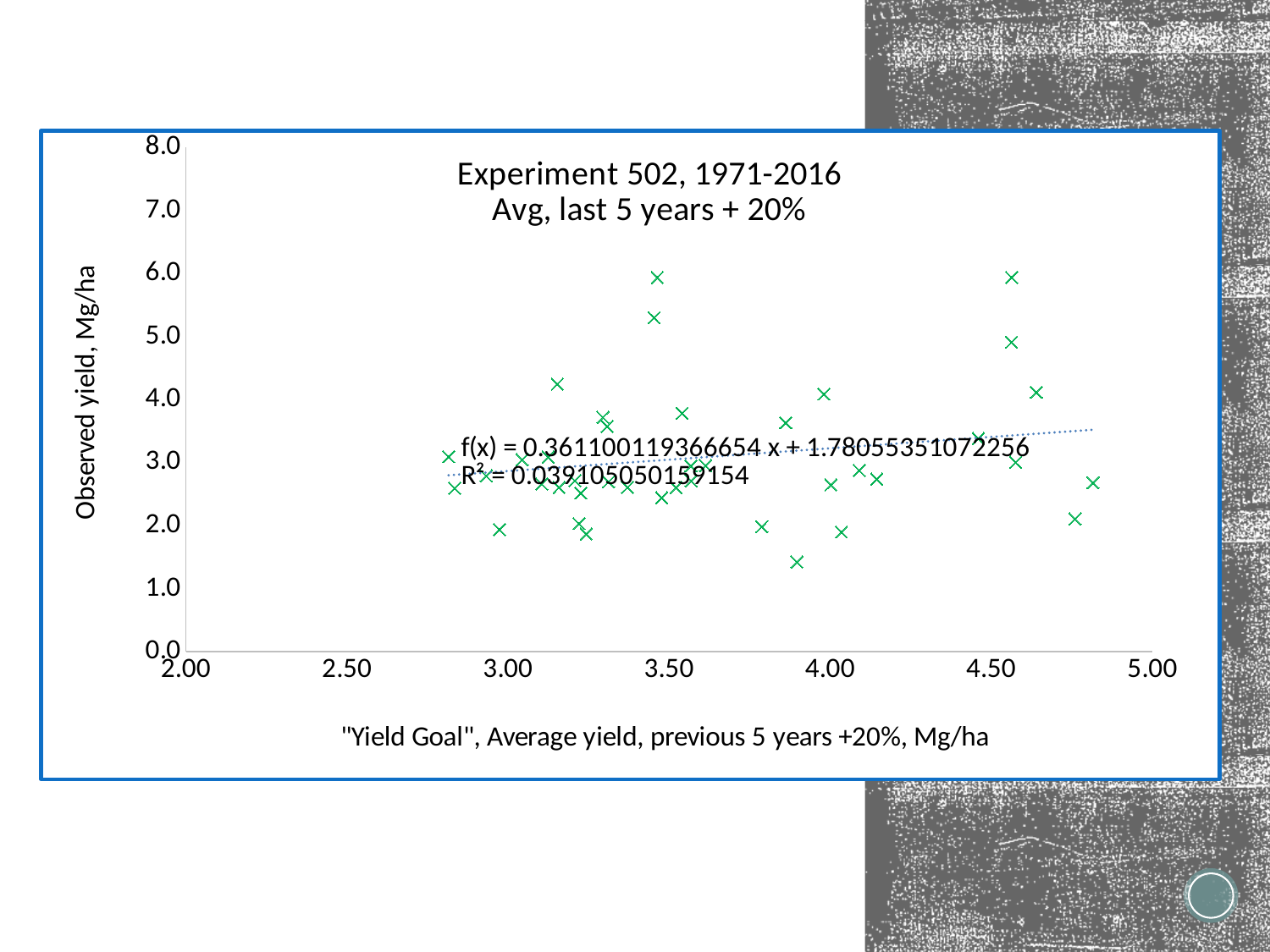
What R² value is printed on the chart for the trendline? 0.039105050159154 Is the lowest observed yield plotted on the chart greater or less than 2.0? less Is the smallest yield goal value plotted on the chart greater or less than 2.50? greater What is the label of the vertical axis? Observed yield, Mg/ha What is the slope of the fitted trendline equation shown on the chart? 0.361100119366654 Is the largest yield goal value plotted on the chart greater or less than 5.00? less What is the title of the chart? Experiment 502, 1971-2016 Avg, last 5 years + 20% What is the intercept of the fitted trendline equation shown on the chart? 1.78055351072256 Does the fitted trendline rise or fall as the yield goal increases? rises What kind of chart is shown on the slide? scatter chart